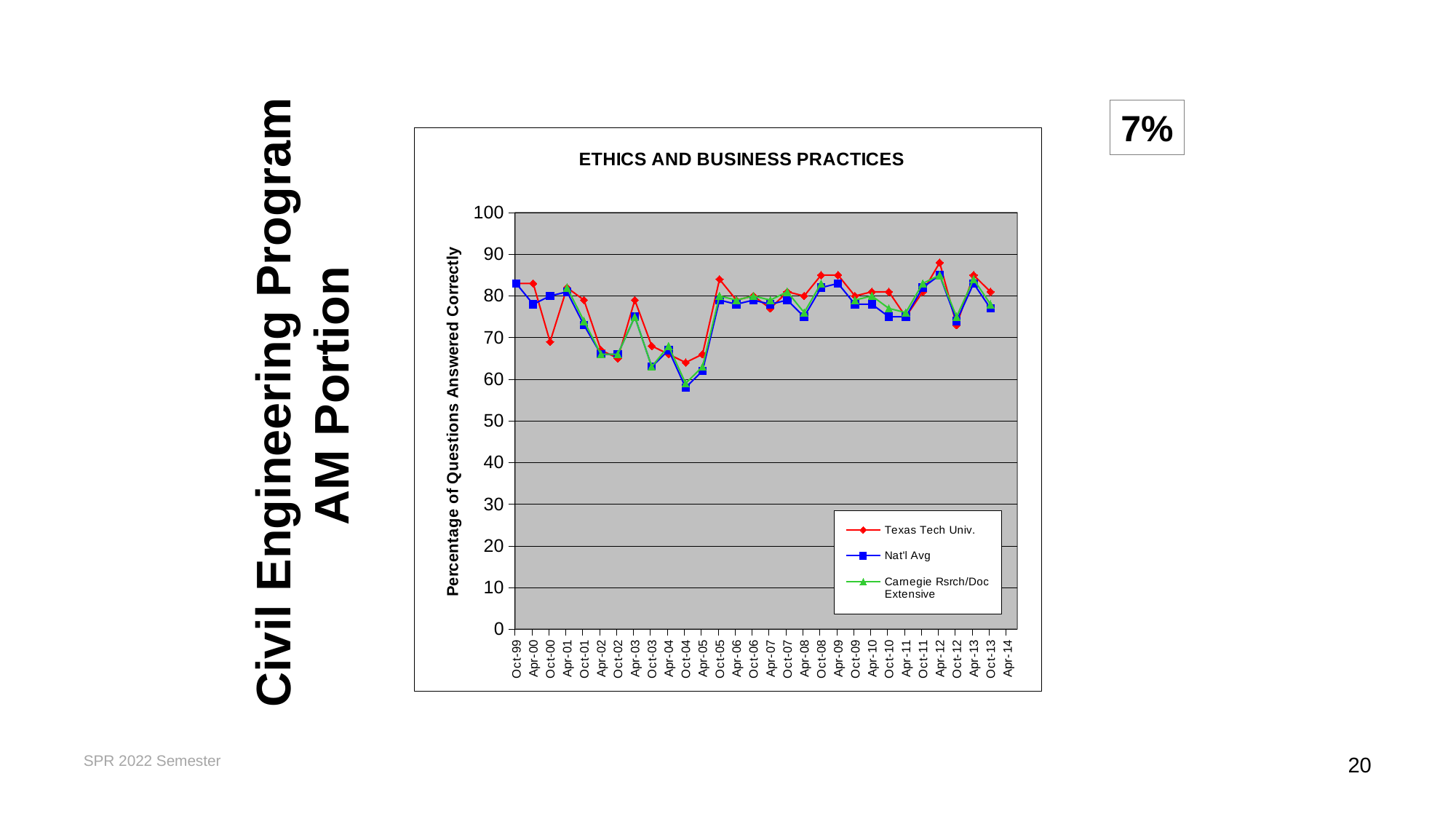
What type of chart is shown on the slide? line chart At Oct-00, which series has the higher value, Texas Tech Univ. or Nat'l Avg? Nat'l Avg Is the value for Texas Tech Univ. at Apr-12 greater or less than 80? greater What is the label on the vertical axis of the chart? Percentage of Questions Answered Correctly At which period does the Nat'l Avg series reach its lowest value? Oct-04 Is the value for Nat'l Avg at Oct-04 greater or less than 60? less At Apr-03, which series has the higher value, Texas Tech Univ. or Nat'l Avg? Texas Tech Univ. Is the value for Texas Tech Univ. at Oct-04 greater or less than 70? less What is the title of the chart? ETHICS AND BUSINESS PRACTICES How many series does the legend list? 3